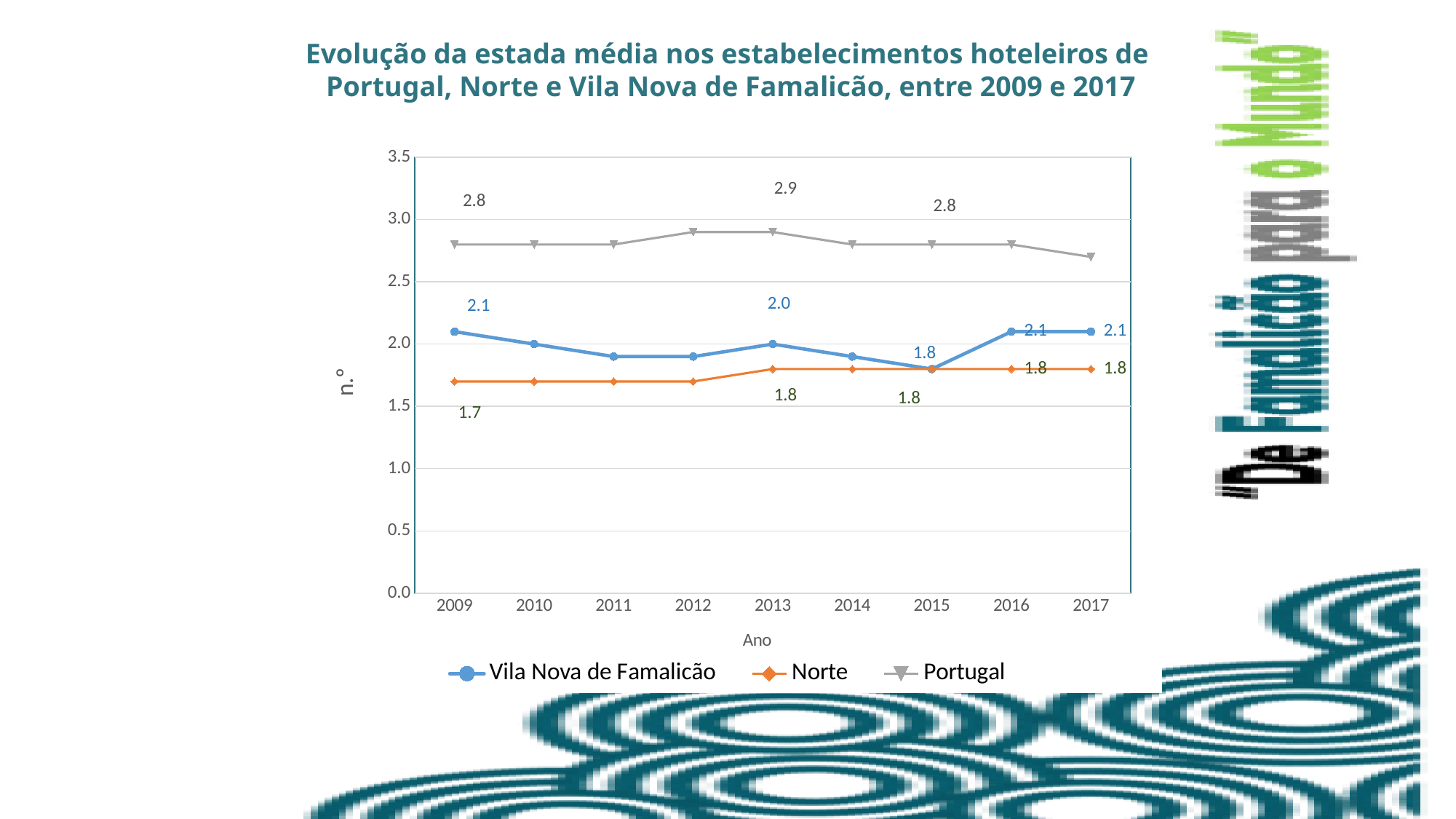
What is the title of the x axis? Ano What is the value for Norte in 2009? 1.7 What is the difference between the Vila Nova de Famalicão value and the Norte value in 2016? 0.3 Which series has the highest value in 2013? Portugal Is the value for Portugal in 2017 greater or less than 3.0? less What kind of chart is shown on the slide? line chart What is the difference between the Portugal value and the Norte value in 2009? 1.1 How many series does the legend list? 3 How many years are plotted along the x axis? 9 What is the value for Vila Nova de Famalicão in 2009? 2.1 What is the value for Portugal in 2013? 2.9 What is the value for Vila Nova de Famalicão in 2015? 1.8